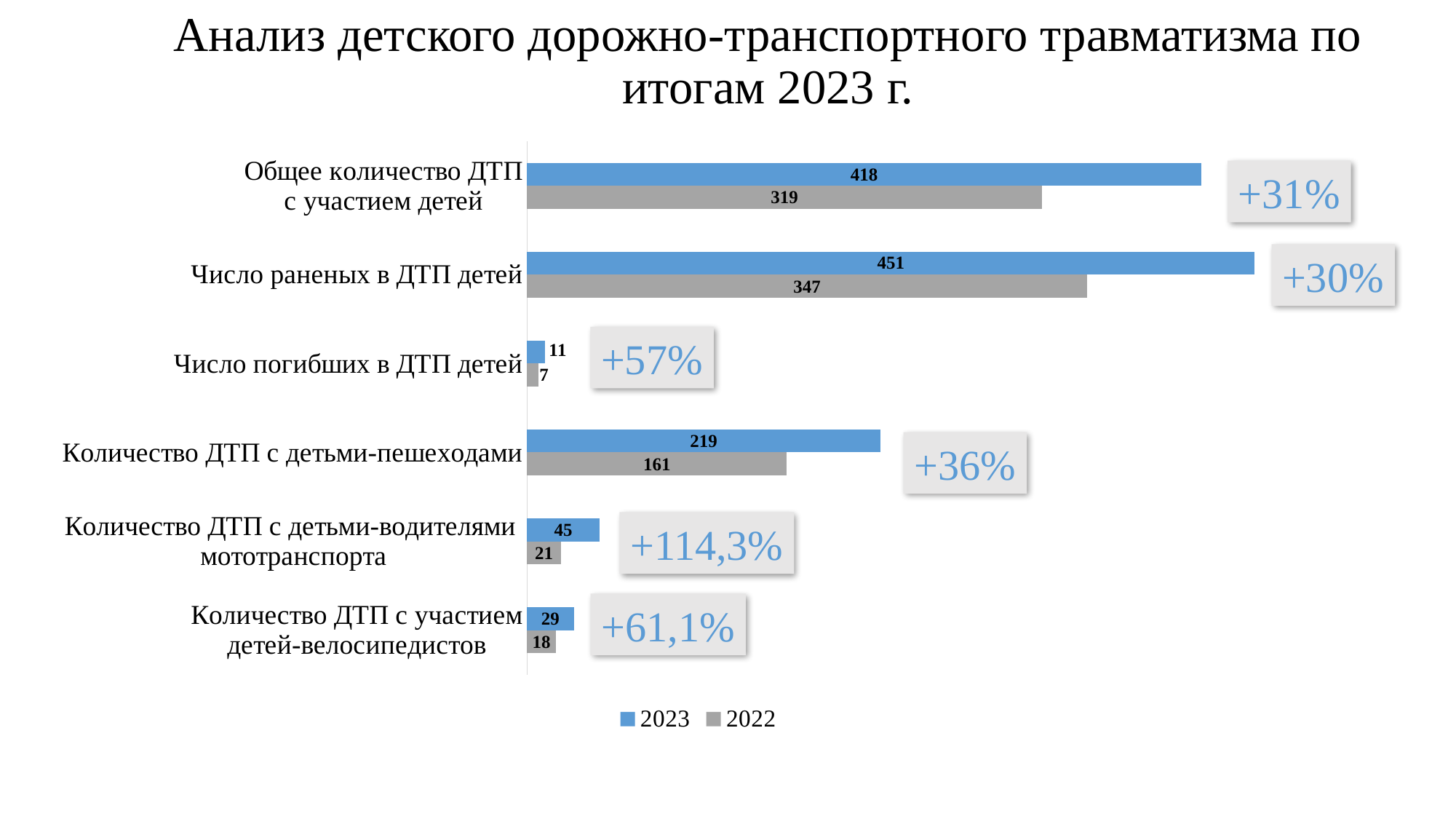
What kind of chart is shown on the slide? Bar chart What is the difference between the 2023 and 2022 values for "Количество ДТП с детьми-пешеходами"? 58 What is the 2023 value for "Количество ДТП с детьми-водителями мототранспорта"? 45 What is the 2022 value for "Число погибших в ДТП детей"? 7 Which category has the highest 2023 value? Число раненых в ДТП детей Which is larger for "Количество ДТП с участием детей-велосипедистов": the 2023 value or the 2022 value? 2023 What is the 2023 value for "Общее количество ДТП с участием детей"? 418 What is the 2022 value for "Число раненых в ДТП детей"? 347 Which category has the lowest 2022 value? Число погибших в ДТП детей What percentage change is shown next to "Количество ДТП с детьми-водителями мототранспорта"? +114,3% How many categories are shown on the chart? 6 How many series does the legend list? 2